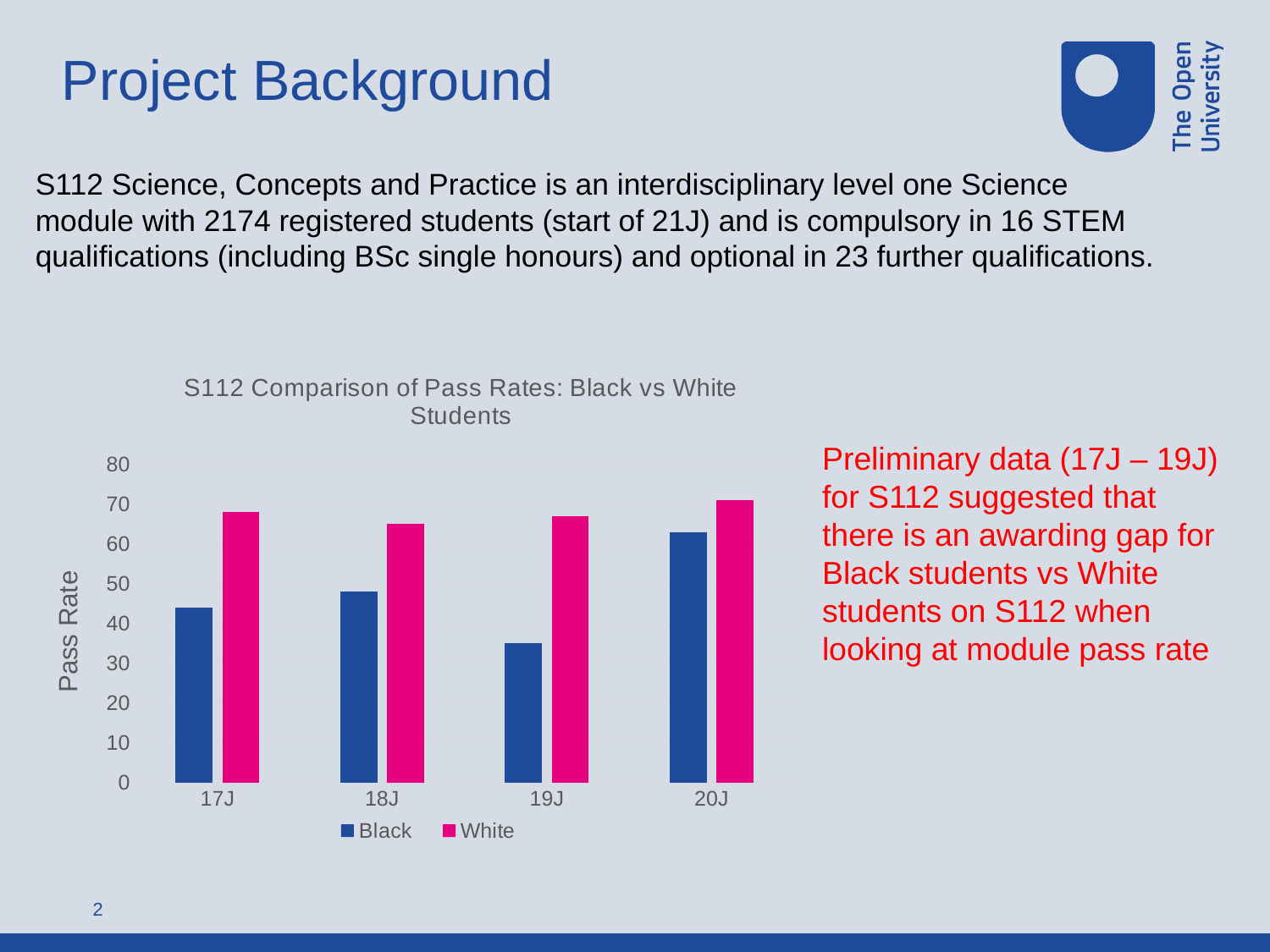
Is the pass rate for White students in 19J greater or less than 70? less What kind of chart is shown on the slide? bar chart In which presentation is the pass rate for Black students highest? 20J Is the pass rate for Black students in 19J greater or less than 40? less In 17J, which group has the higher pass rate, Black or White students? White How many series does the legend list? 2 How many presentations (categories) are shown on the x axis? 4 What is the title of the chart? S112 Comparison of Pass Rates: Black vs White Students What is the label on the y axis of the chart? Pass Rate In which presentation is the pass rate for Black students lowest? 19J Is the pass rate for White students in 17J greater or less than 60? greater